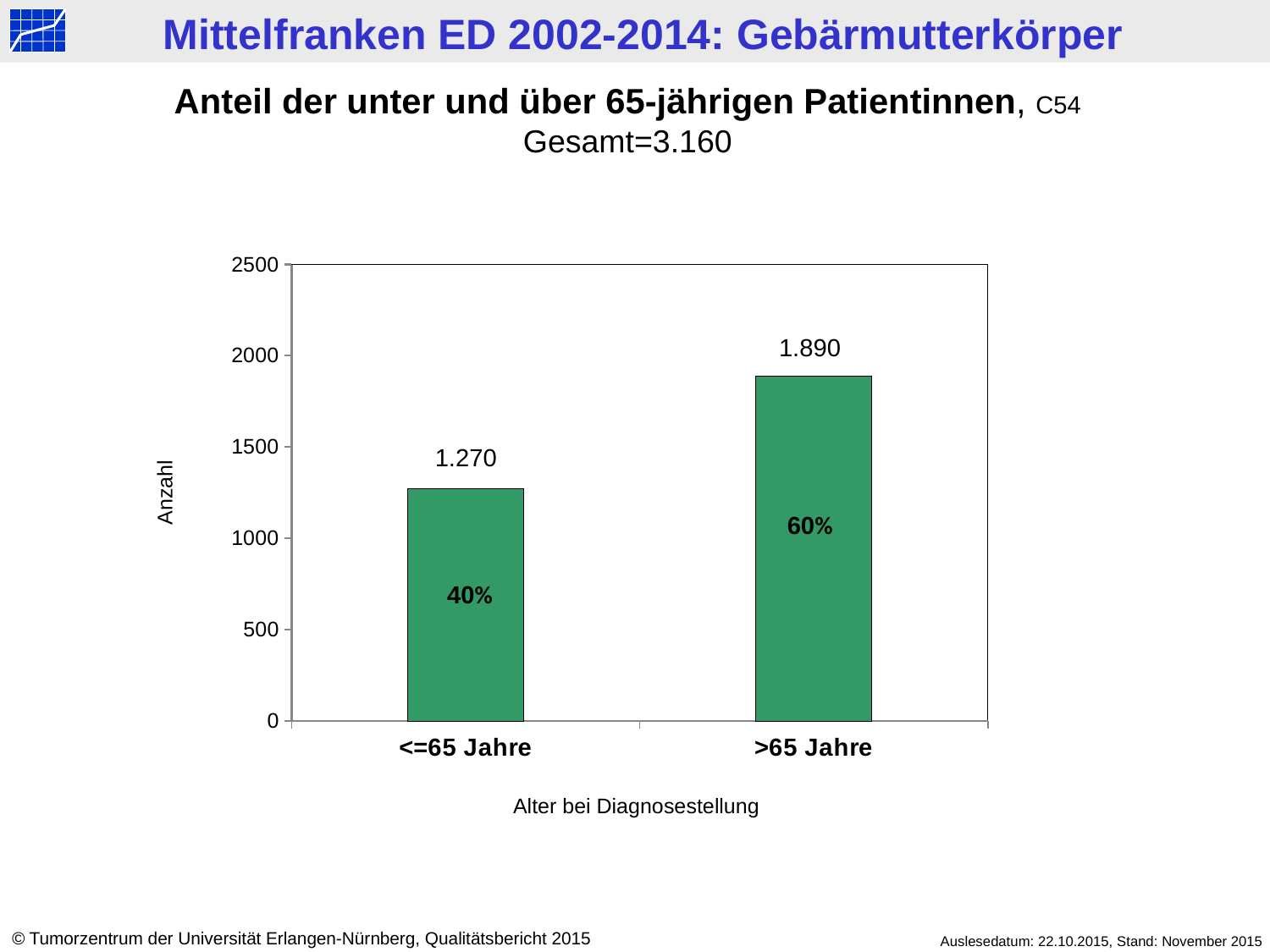
What percentage is printed inside the "<=65 Jahre" bar? 40% What is the value (Anzahl) for the "<=65 Jahre" category? 1.270 What kind of chart is shown on the slide? bar chart What is the value (Anzahl) for the ">65 Jahre" category? 1.890 Which age category has the higher number of patients? >65 Jahre What percentage is printed inside the ">65 Jahre" bar? 60% How many categories are shown on the x axis? 2 Is the value for "<=65 Jahre" greater or less than 1500? less What is the label of the x axis? Alter bei Diagnosestellung Which age category has the lower number of patients? <=65 Jahre Is the value for ">65 Jahre" greater or less than 1500? greater What is the difference in Anzahl between the ">65 Jahre" and "<=65 Jahre" categories? 620